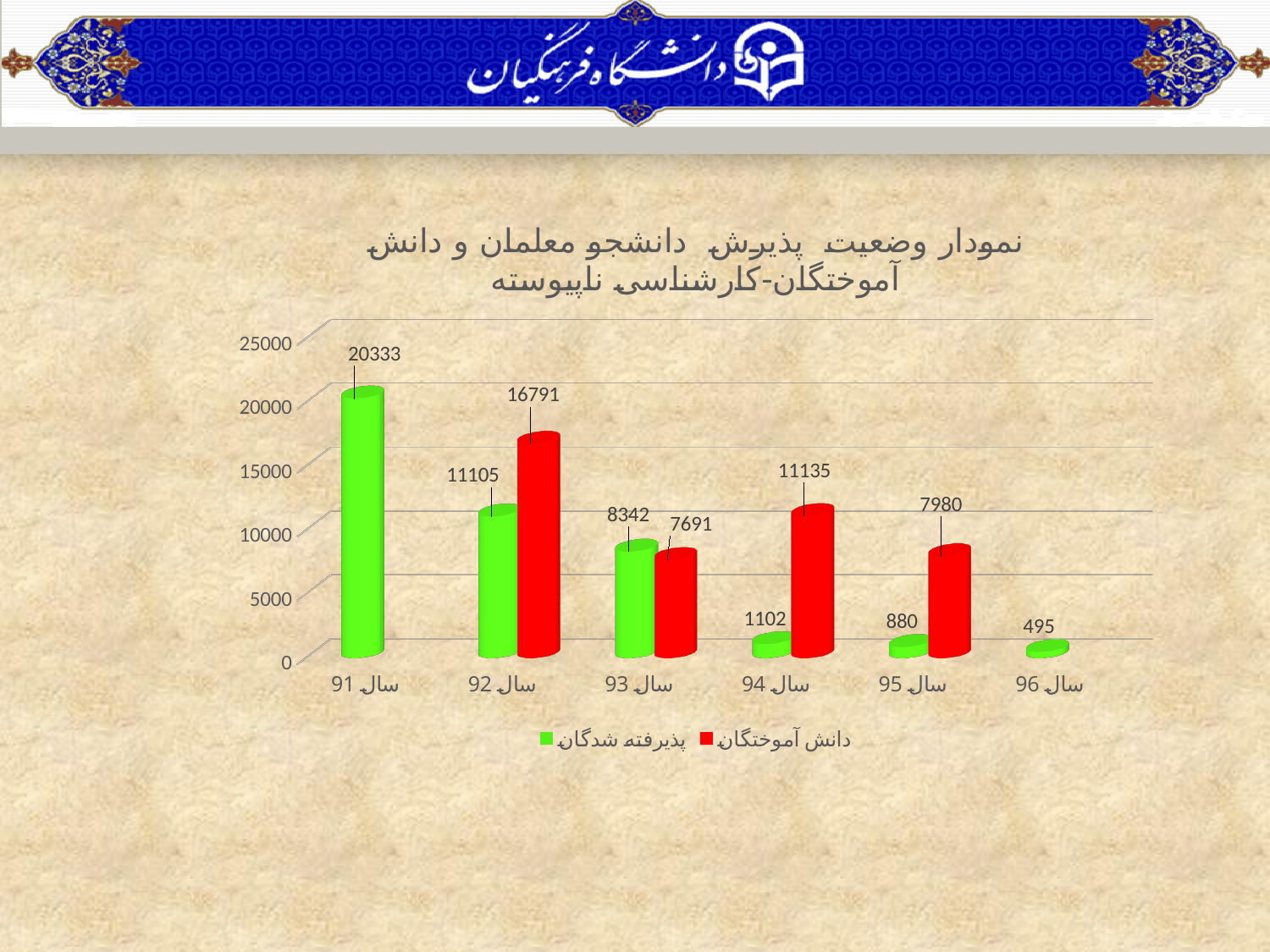
What is the value for پذیرفته شدگان in سال 91? 20333 What is the value for دانش آموختگان in سال 94? 11135 Do the values for پذیرفته شدگان rise or fall from سال 91 to سال 96? fall How many series does the legend list? 2 Which year has the lowest value for دانش آموختگان? سال 93 What kind of chart is shown on the slide? bar chart In سال 93, which is larger: پذیرفته شدگان or دانش آموختگان? پذیرفته شدگان What is the difference between پذیرفته شدگان and دانش آموختگان in سال 92? 5686 What is the value for پذیرفته شدگان in سال 96? 495 How many years are shown on the x axis? 6 What is the value for دانش آموختگان in سال 92? 16791 Which year has the highest value for پذیرفته شدگان? سال 91